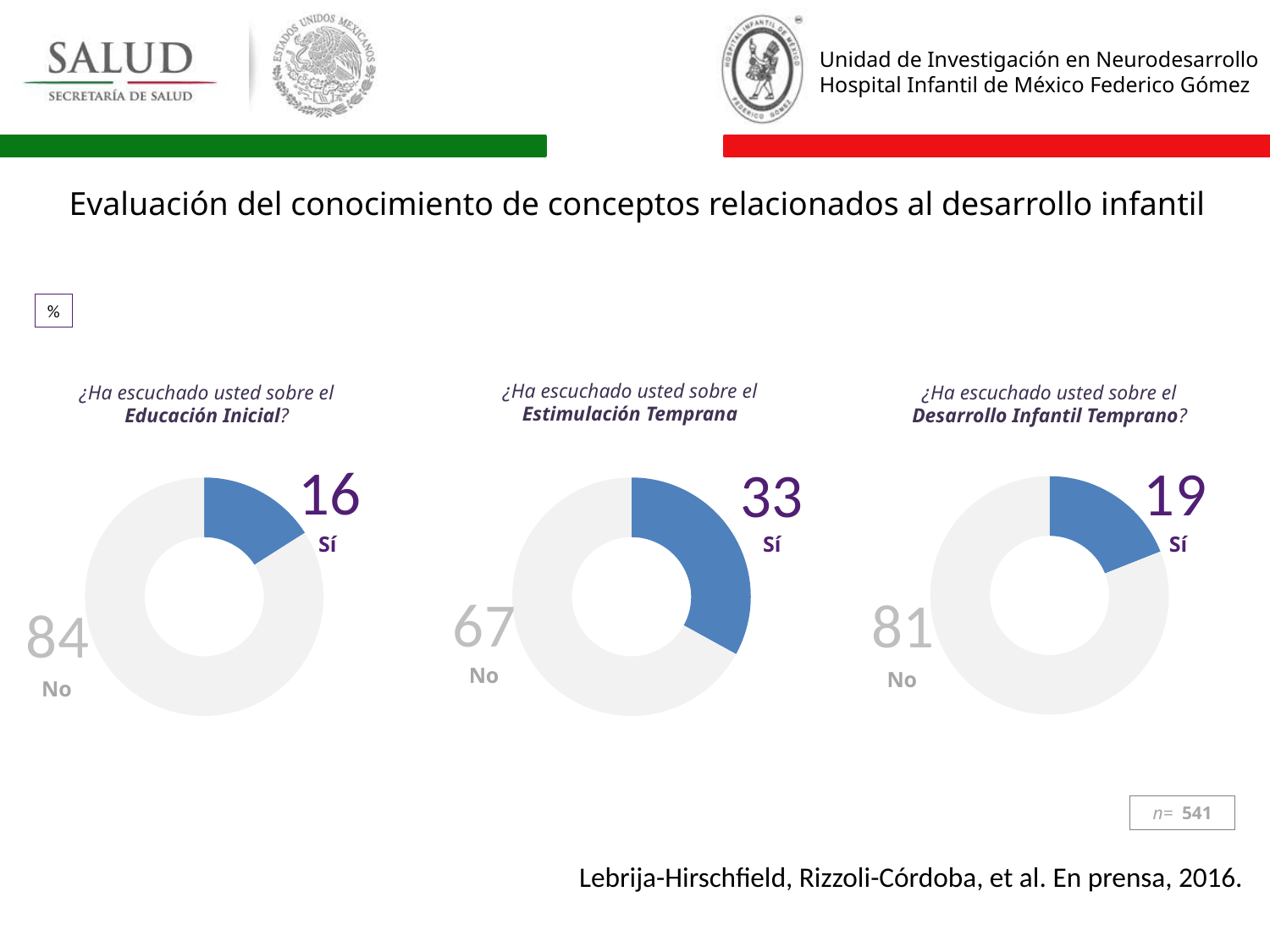
In the 'Desarrollo Infantil Temprano' donut chart, what is the value for 'Sí'? 19 In the 'Estimulación Temprana' donut chart, what is the value for 'No'? 67 In the 'Educación Inicial' donut chart, what is the value for 'Sí'? 16 How many donut charts are shown on the slide? 3 Across the three donut charts, which concept has the lowest 'Sí' value? Educación Inicial What kind of chart is used to show the responses for each concept on this slide? Donut (pie) chart In the 'Desarrollo Infantil Temprano' donut chart, what is the value for 'No'? 81 In the 'Estimulación Temprana' donut chart, what is the value for 'Sí'? 33 In the 'Educación Inicial' donut chart, what is the value for 'No'? 84 Across the three donut charts, which concept has the highest 'Sí' value? Estimulación Temprana Which is larger: the 'Sí' value in the 'Desarrollo Infantil Temprano' chart or the 'Sí' value in the 'Educación Inicial' chart? Desarrollo Infantil Temprano What is the difference between the 'Sí' value in the 'Estimulación Temprana' chart and the 'Sí' value in the 'Educación Inicial' chart? 17